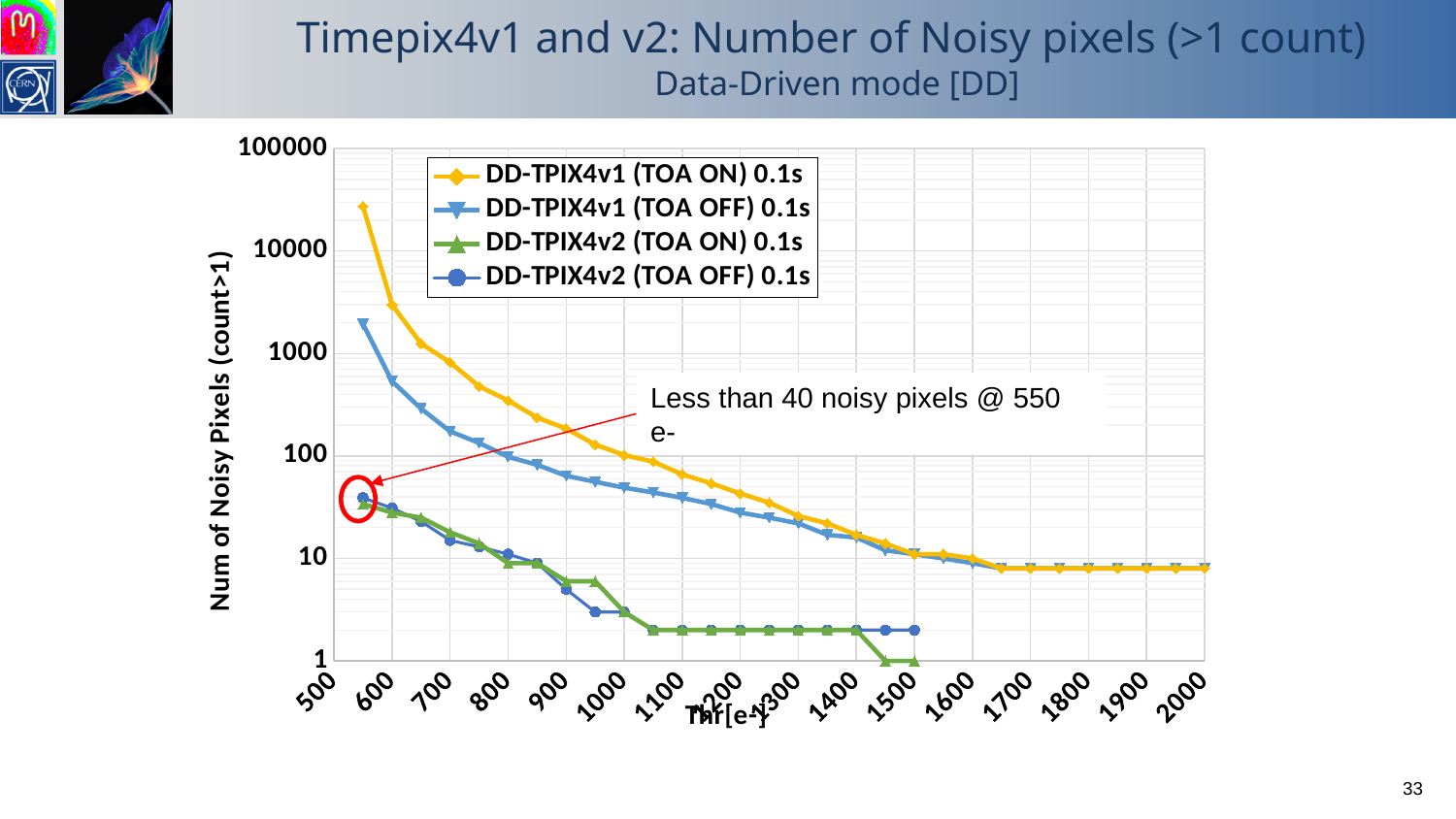
Which series has the lowest number of noisy pixels at a threshold of 1500 e-? DD-TPIX4v2 (TOA ON) 0.1s Is the value for DD-TPIX4v1 (TOA OFF) 0.1s at 550 e- greater or less than 1000? greater What kind of chart is shown on the slide? line chart Which series has the highest number of noisy pixels at a threshold of 550 e-? DD-TPIX4v1 (TOA ON) 0.1s Is the value for DD-TPIX4v1 (TOA ON) 0.1s at 2000 e- greater or less than 10? less Do the number of noisy pixels rise or fall as the threshold increases along the x axis? fall Is the value for DD-TPIX4v1 (TOA ON) 0.1s at 550 e- greater or less than 10000? greater At a threshold of 1000 e-, which is larger: DD-TPIX4v1 (TOA ON) 0.1s or DD-TPIX4v1 (TOA OFF) 0.1s? DD-TPIX4v1 (TOA ON) 0.1s What is the label of the y axis? Num of Noisy Pixels (count>1) How many series does the legend list? 4 What does the annotation on the chart say about the noisy pixels at 550 e-? Less than 40 noisy pixels @ 550 e-